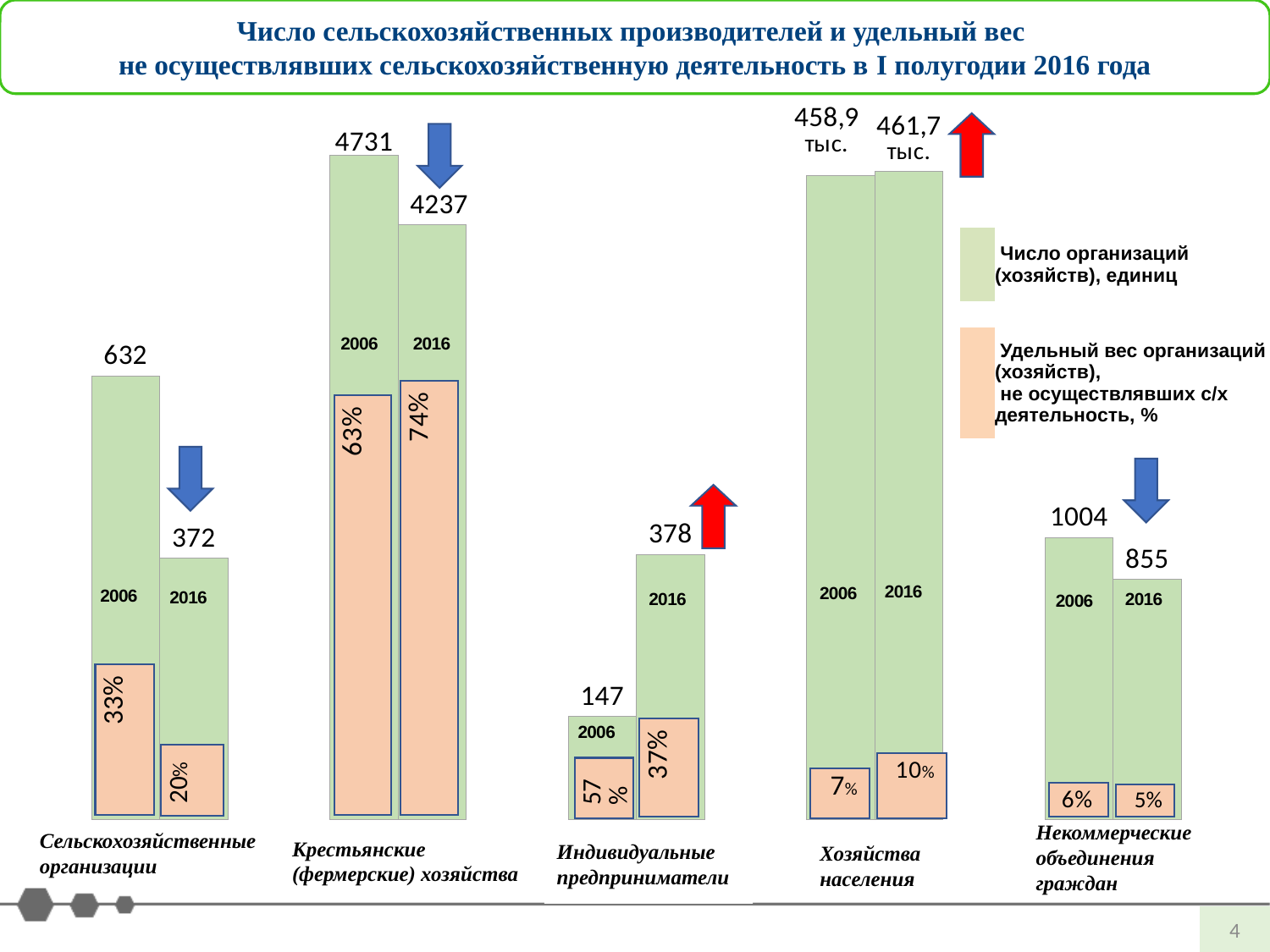
By how much did the number of индивидуальные предприниматели change from 2006 to 2016? 231 How many categories of agricultural producers are shown on the chart? 5 What share of индивидуальные предприниматели did not carry out agricultural activity in 2016? 37% By how much did the number of сельскохозяйственные организации fall from 2006 to 2016? 260 What is the number of крестьянские (фермерские) хозяйства in 2006? 4731 Which category has the highest share of organisations not carrying out agricultural activity in 2016? Крестьянские (фермерские) хозяйства What is the number of хозяйства населения in 2016? 461,7 тыс. What is the number of сельскохозяйственные организации in 2016? 372 What type of chart is shown on the slide? Bar chart Which category has the lowest share of organisations not carrying out agricultural activity in 2016? Некоммерческие объединения граждан Which is larger: the number of некоммерческие объединения граждан in 2006 or in 2016? 2006 What share of некоммерческие объединения граждан did not carry out agricultural activity in 2006? 6%